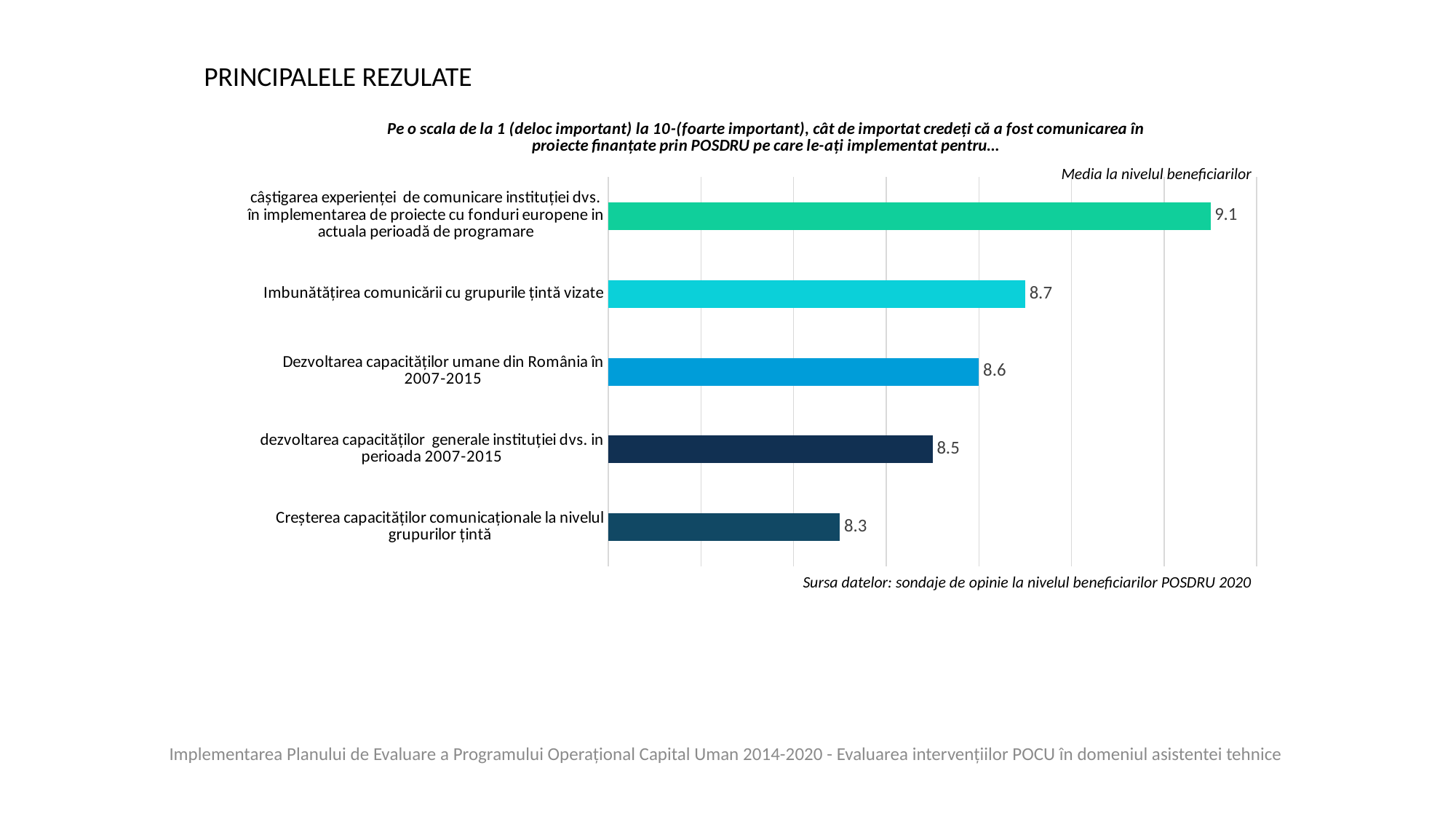
What is the label shown above the chart at the top right, describing the measure plotted? Media la nivelul beneficiarilor What is the difference between the values for "Imbunătățirea comunicării cu grupurile țintă vizate" and "dezvoltarea capacităților generale instituției dvs. in perioada 2007-2015"? 0.2 Which category has the highest value? câștigarea experienței de comunicare instituției dvs. în implementarea de proiecte cu fonduri europene in actuala perioadă de programare How many categories are shown in the chart? 5 What is the value for "Creșterea capacităților comunicaționale la nivelul grupurilor țintă"? 8.3 What is the difference between the highest value (9.1) and the lowest value (8.3)? 0.8 What is the data source stated below the chart? Sursa datelor: sondaje de opinie la nivelul beneficiarilor POSDRU 2020 What kind of chart is shown on the slide? Bar chart What is the value for "Dezvoltarea capacităților umane din România în 2007-2015"? 8.6 What is the value for "Imbunătățirea comunicării cu grupurile țintă vizate"? 8.7 Which category has the lowest value? Creșterea capacităților comunicaționale la nivelul grupurilor țintă Which is larger: the value for "Dezvoltarea capacităților umane din România în 2007-2015" or the value for "dezvoltarea capacităților generale instituției dvs. in perioada 2007-2015"? Dezvoltarea capacităților umane din România în 2007-2015